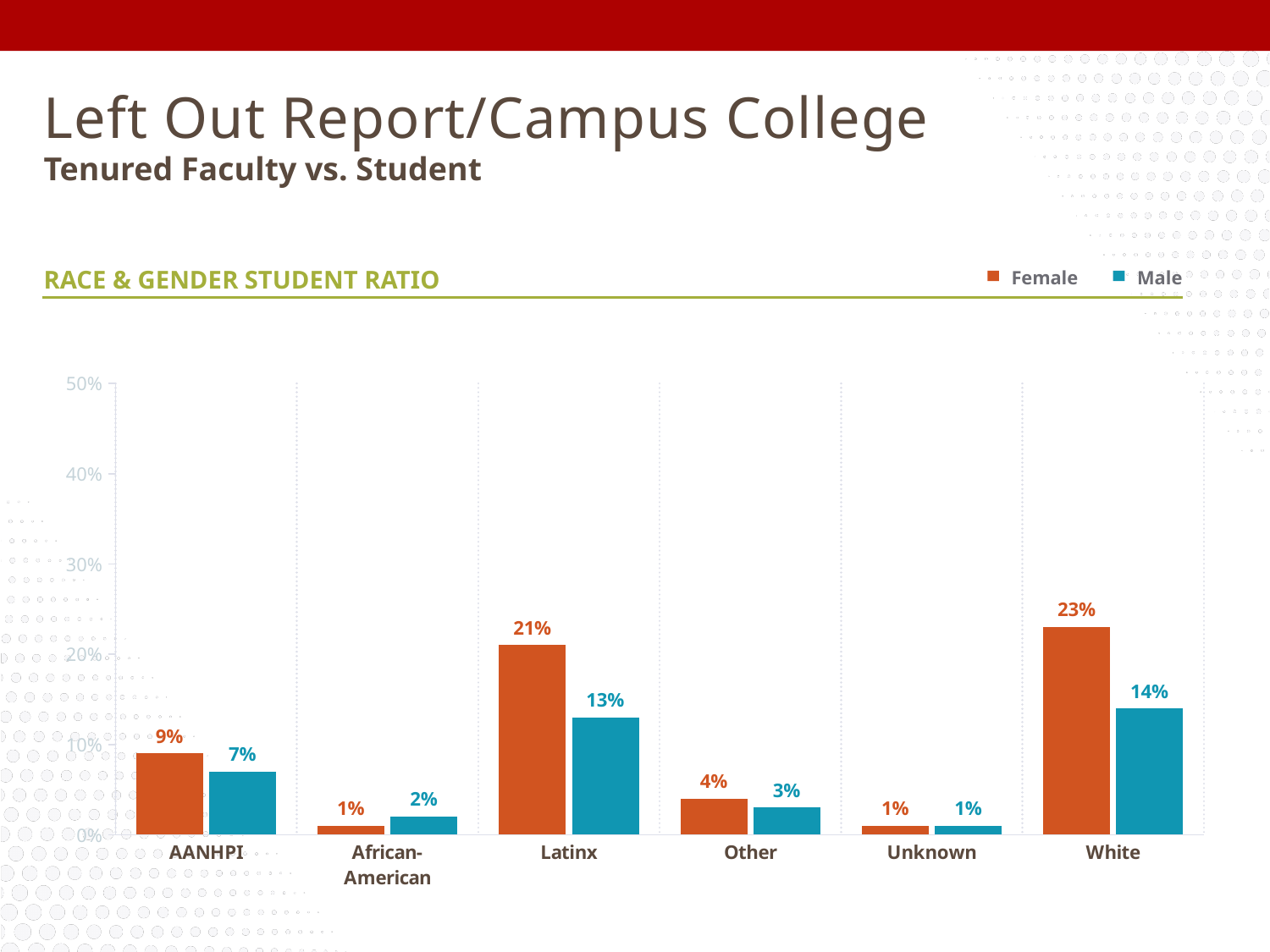
What is the title of the chart? RACE & GENDER STUDENT RATIO What is the Female value for Latinx? 21% How many categories are shown on the x axis? 6 Is the Female value for Latinx greater or less than 20%? greater What is the Male value for White? 14% What kind of chart is shown on the slide? Bar chart What is the Male value for AANHPI? 7% Which category has the lowest Male value? Unknown What is the difference between the Female and Male values for White? 9% Which category has the highest Female value? White Which is larger for African-American, the Female value or the Male value? Male How many series does the legend list? 2